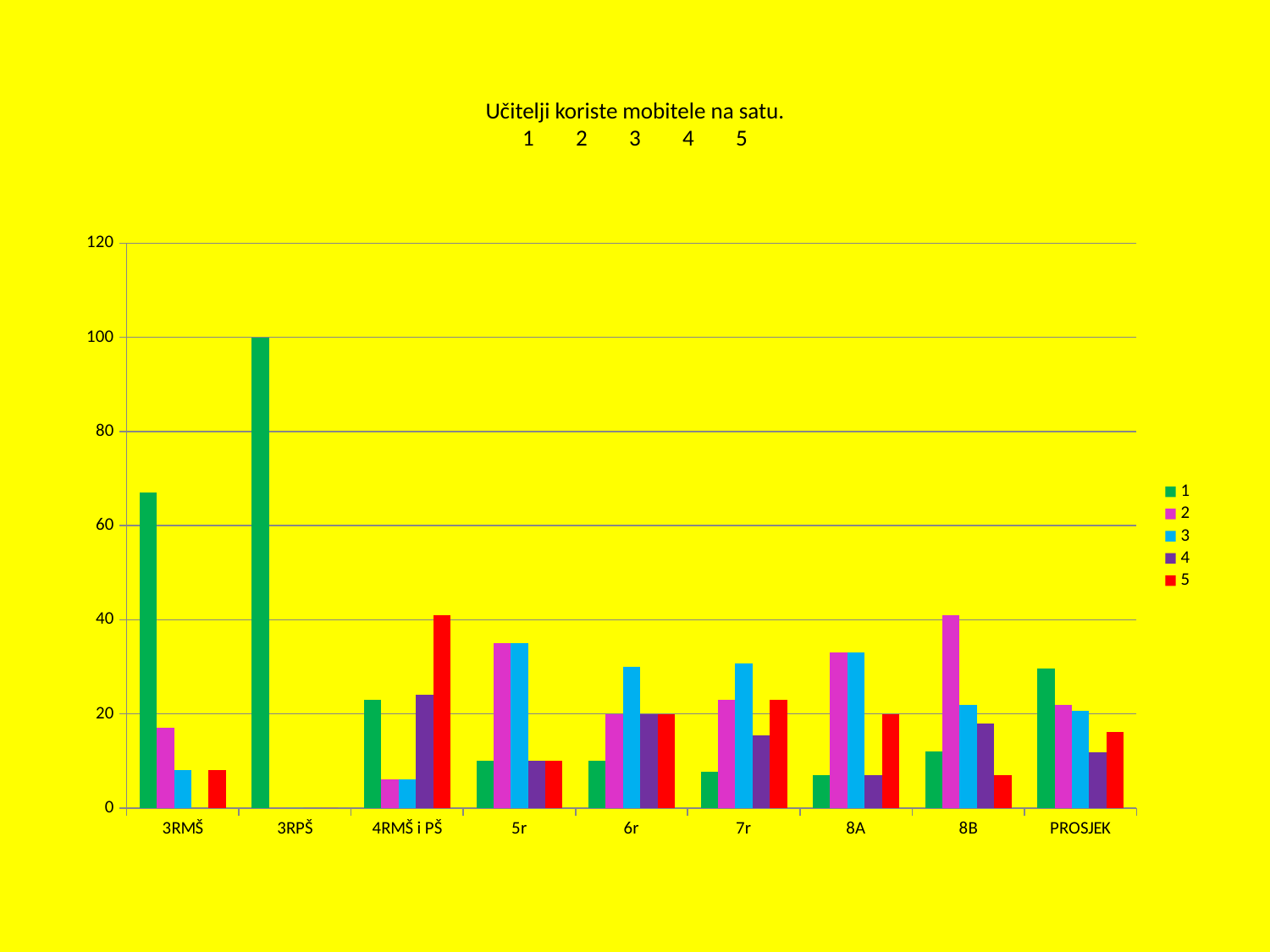
What is the title of the chart? Učitelji koriste mobitele na satu. Which category has the tallest bar in the chart? 3RPŠ Which series has the highest value for 8B? 2 What is the value of series 1 for 3RPŠ? 100 Is the value of series 1 for 3RMŠ greater or less than 60? greater Which series has the lowest value for 7r? 1 Is the value of series 1 for PROSJEK greater or less than 20? greater Is the value of series 2 for 5r greater or less than 40? less How many series does the legend list? 5 What kind of chart is shown on the slide? bar chart How many categories are shown along the x axis? 9 For 8A, which is larger: series 4 or series 5? series 5